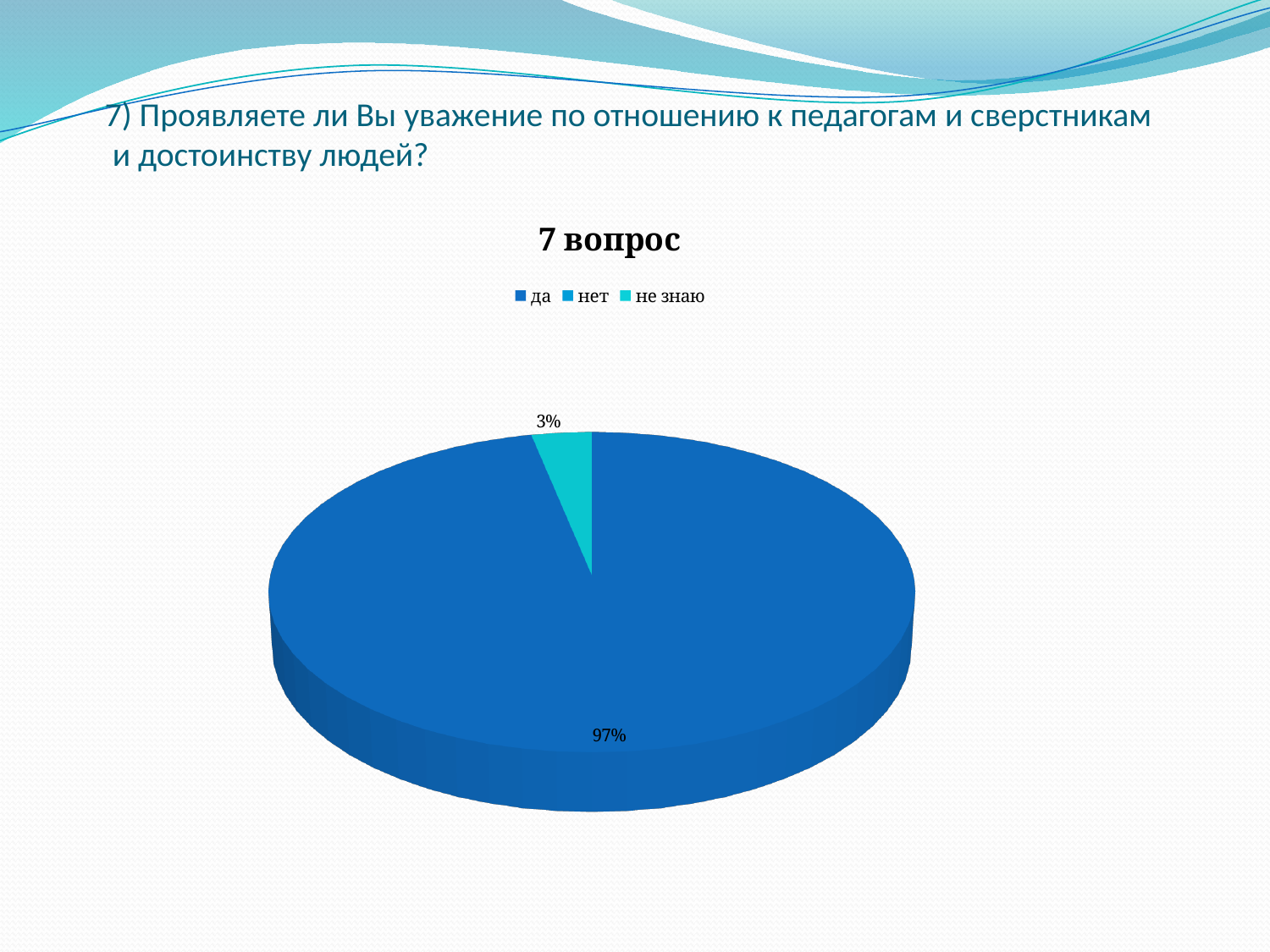
What share of the pie does the "да" slice take? 97% What percentage of the pie is labelled for the "да" slice? 97% What kind of chart is shown on the slide? pie chart Which of the two labelled slices, "да" or "не знаю", is smaller? не знаю How many entries does the chart legend list? 3 Which answer option has the largest slice of the pie? да What percentage of the pie is labelled for the "не знаю" slice? 3% What are the three legend entries of the chart, in order? да, нет, не знаю What is the difference in percentage points between the "да" slice and the "не знаю" slice? 94 Is the share for "да" greater or less than 50%? greater How many slices of the pie have a percentage label printed on the chart? 2 What is the title of the chart? 7 вопрос